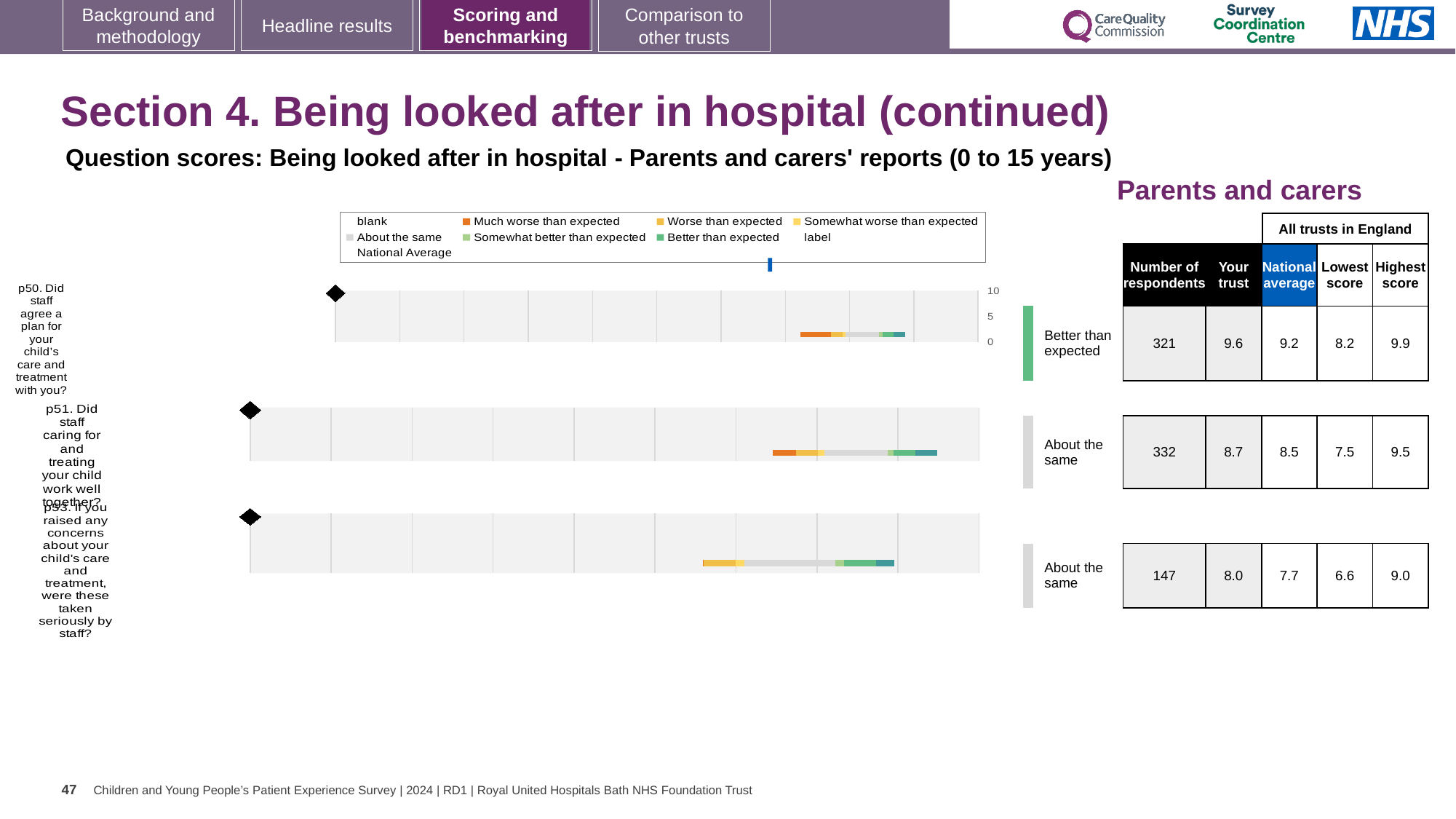
Which of the three questions has the lowest national average score? p53 How many survey questions (p50, p51, p53) are plotted on this slide? 3 What is the difference between the 'Your trust' score and the national average for p51? 0.2 What is the highest score among all trusts in England for p50? 9.9 What is the national average score for p51 (Did staff caring for and treating your child work well together?)? 8.5 How many respondents answered p53 (If you raised any concerns about your child's care and treatment, were these taken seriously by staff?)? 147 What benchmark category is shown for p50 (Did staff agree a plan for your child's care and treatment with you?)? Better than expected Is the 'Your trust' score for p50 higher or lower than the national average? higher What is the lowest score among all trusts in England for p53? 6.6 What kind of chart is used to show the question scores on this slide? bar chart Which of the three questions has the highest 'Your trust' score? p50 What is the 'Your trust' score for p50 (Did staff agree a plan for your child's care and treatment with you?)? 9.6